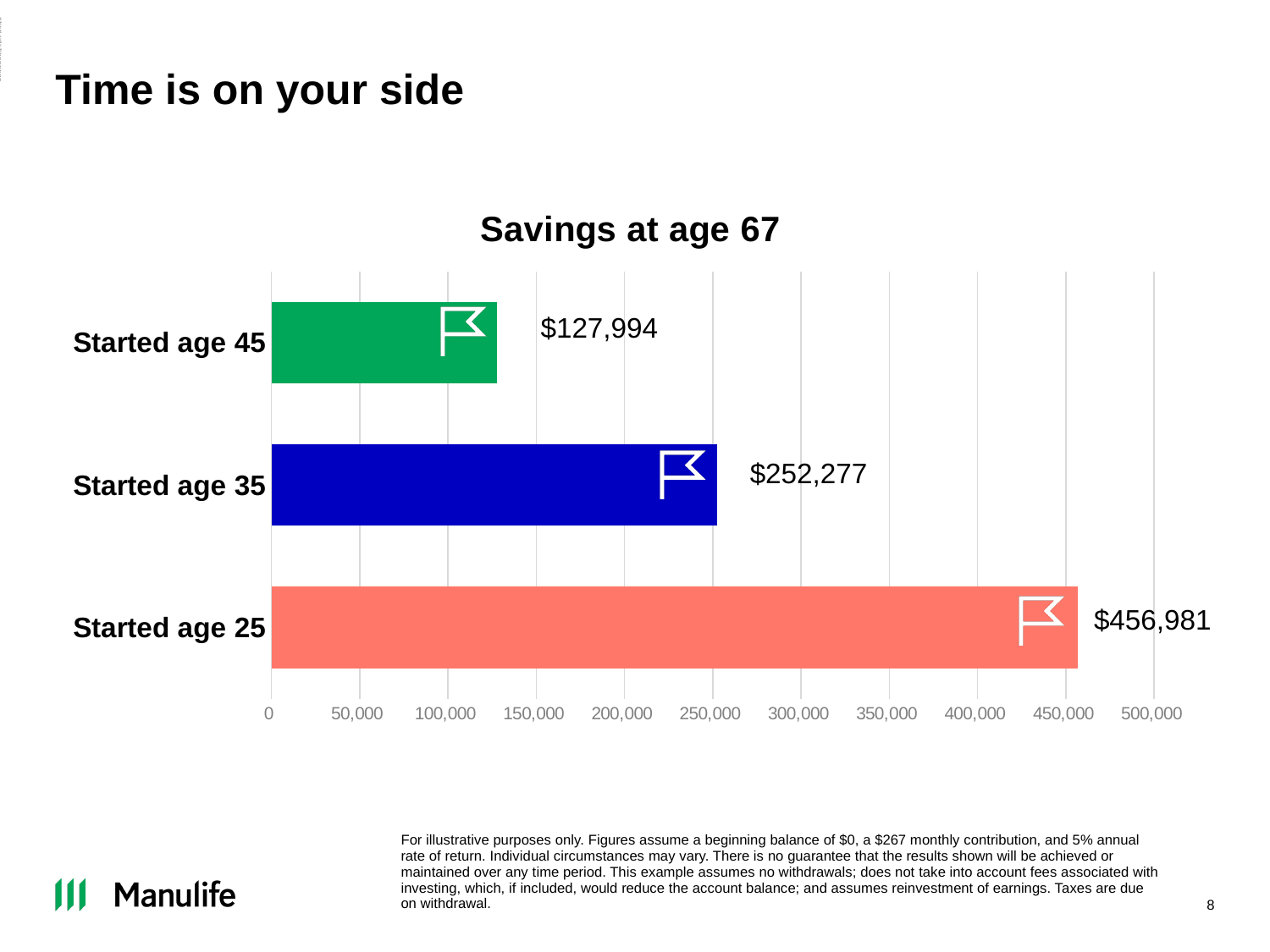
Which category has the highest savings at age 67? Started age 25 What is the difference between the values for Started age 25 and Started age 45? $328,987 What kind of chart is shown on the slide? bar chart Which is larger, the value for Started age 35 or the value for Started age 45? Started age 35 Which category has the lowest savings at age 67? Started age 45 What is the value for Started age 45? $127,994 What is the difference between the values for Started age 35 and Started age 45? $124,283 Is the value for Started age 35 greater or less than 300,000? less What is the value for Started age 25? $456,981 What is the value for Started age 35? $252,277 How many categories are shown in the chart? 3 What is the title of the chart? Savings at age 67